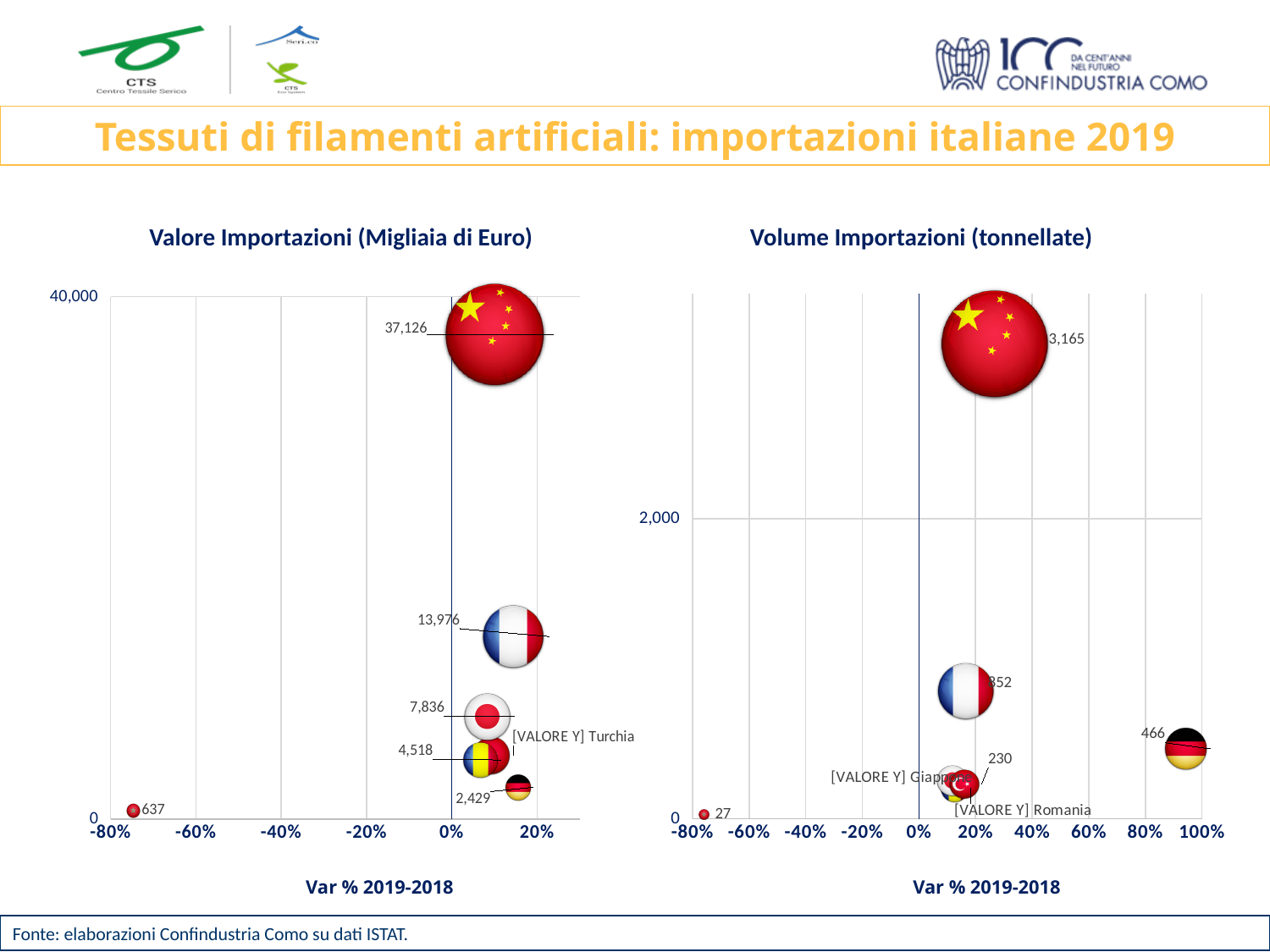
In the right chart 'Volume Importazioni (tonnellate)', what is the difference between the bubble labelled 852 and the bubble labelled 466? 386 What kind of chart is the left chart, 'Valore Importazioni (Migliaia di Euro)'? Bubble chart In the right chart 'Volume Importazioni (tonnellate)', is the bubble labelled 852 above or below the 2,000 gridline on the vertical axis? below In the left chart 'Valore Importazioni (Migliaia di Euro)', what is the difference between the bubble labelled 37,126 and the bubble labelled 13,976? 23,150 In the left chart 'Valore Importazioni (Migliaia di Euro)', what is the lowest value labelled on a bubble? 637 In the left chart 'Valore Importazioni (Migliaia di Euro)', what is the highest value labelled on a bubble? 37,126 In the right chart 'Volume Importazioni (tonnellate)', what is the lowest value labelled on a bubble? 27 In the right chart 'Volume Importazioni (tonnellate)', what is the highest value labelled on a bubble? 3,165 What is the x-axis title of the left chart 'Valore Importazioni (Migliaia di Euro)'? Var % 2019-2018 In the right chart 'Volume Importazioni (tonnellate)', is the horizontal position (Var % 2019-2018) of the bubble labelled 466 greater or less than 80%? greater What is the topmost value shown on the vertical axis of the left chart 'Valore Importazioni (Migliaia di Euro)'? 40,000 In the left chart 'Valore Importazioni (Migliaia di Euro)', which is larger: the bubble labelled 7,836 or the bubble labelled 4,518? 7,836